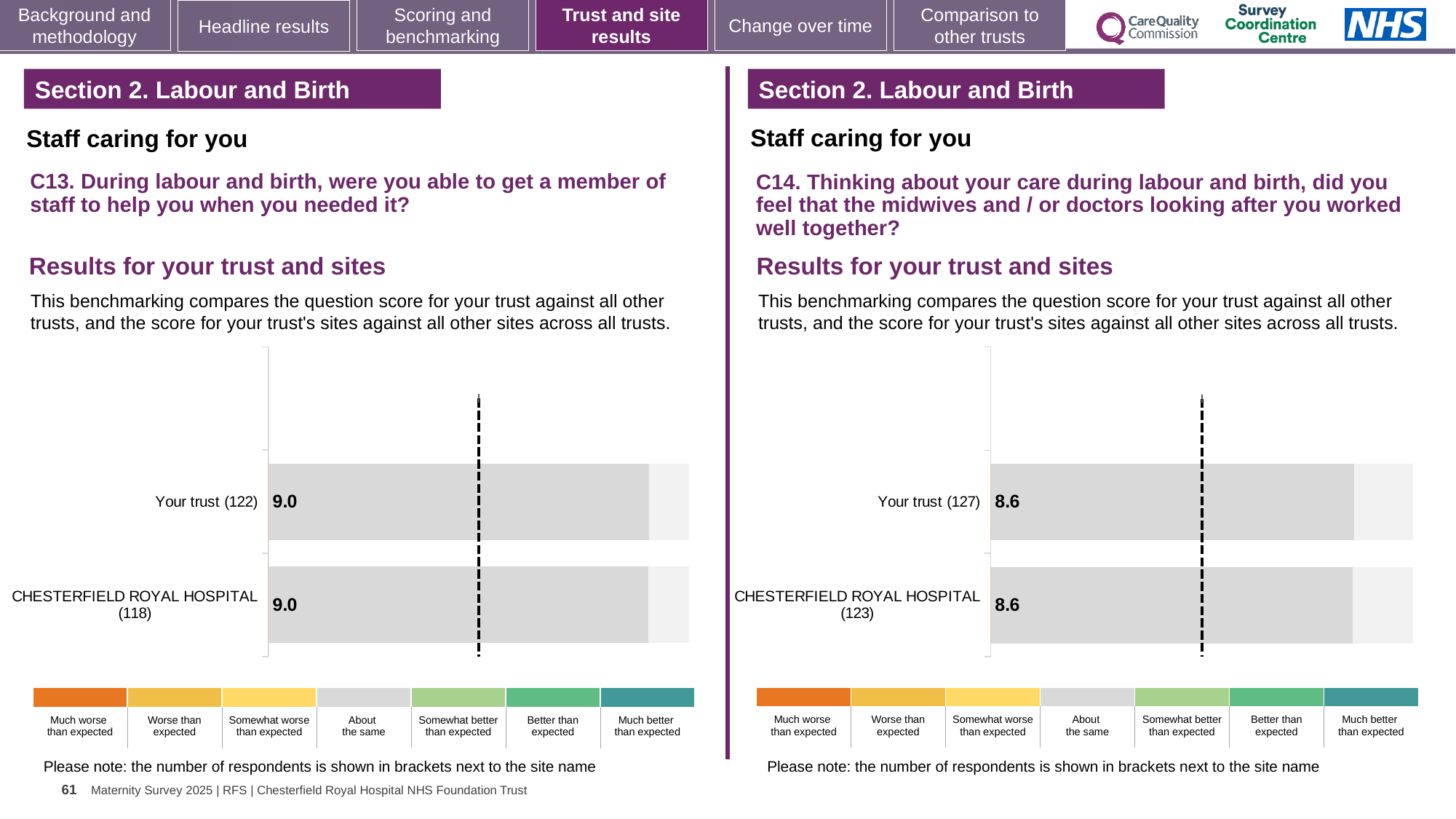
On the left chart (C13), how many respondents are shown in brackets for Your trust? 122 On the right chart (C14), what is the score for Your trust? 8.6 On the right chart (C14), how many respondents are shown in brackets for CHESTERFIELD ROYAL HOSPITAL? 123 On the right chart (C14), what is the score for CHESTERFIELD ROYAL HOSPITAL? 8.6 How many bars are plotted on the left chart (C13)? 2 On the left chart (C13), what is the score for Your trust? 9.0 On the left chart (C13), what is the score for CHESTERFIELD ROYAL HOSPITAL? 9.0 What kind of chart is used on the left (C13)? Bar chart Is the score for Your trust on the left chart (C13) larger or smaller than the score for Your trust on the right chart (C14)? Larger How many bars are plotted on the right chart (C14)? 2 On the left chart (C13), what is the difference between the score for Your trust and the score for CHESTERFIELD ROYAL HOSPITAL? 0.0 On the right chart (C14), what is the difference between the score for Your trust and the score for CHESTERFIELD ROYAL HOSPITAL? 0.0